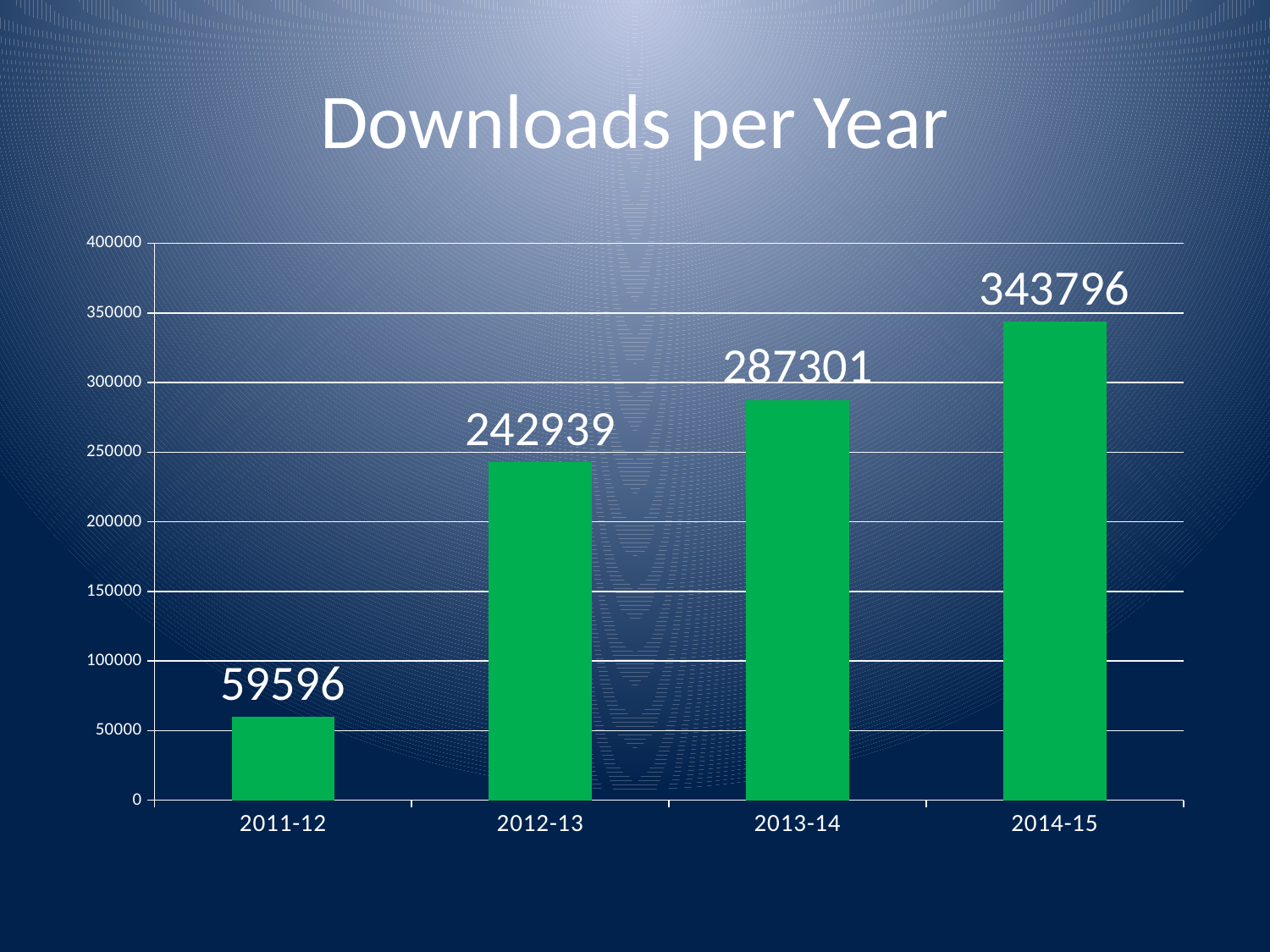
Which year has the lowest number of downloads? 2011-12 What is the value for 2013-14? 287301 What is the difference between the values for 2012-13 and 2011-12? 183343 Which is larger, the value for 2012-13 or the value for 2013-14? 2013-14 What kind of chart is shown on the slide? bar chart What is the value for 2012-13? 242939 How many years are shown on the chart? 4 What is the value for 2011-12? 59596 What is the value for 2014-15? 343796 Do the values rise or fall from 2011-12 to 2014-15? rise What is the difference between the values for 2014-15 and 2013-14? 56495 Which year has the highest number of downloads? 2014-15